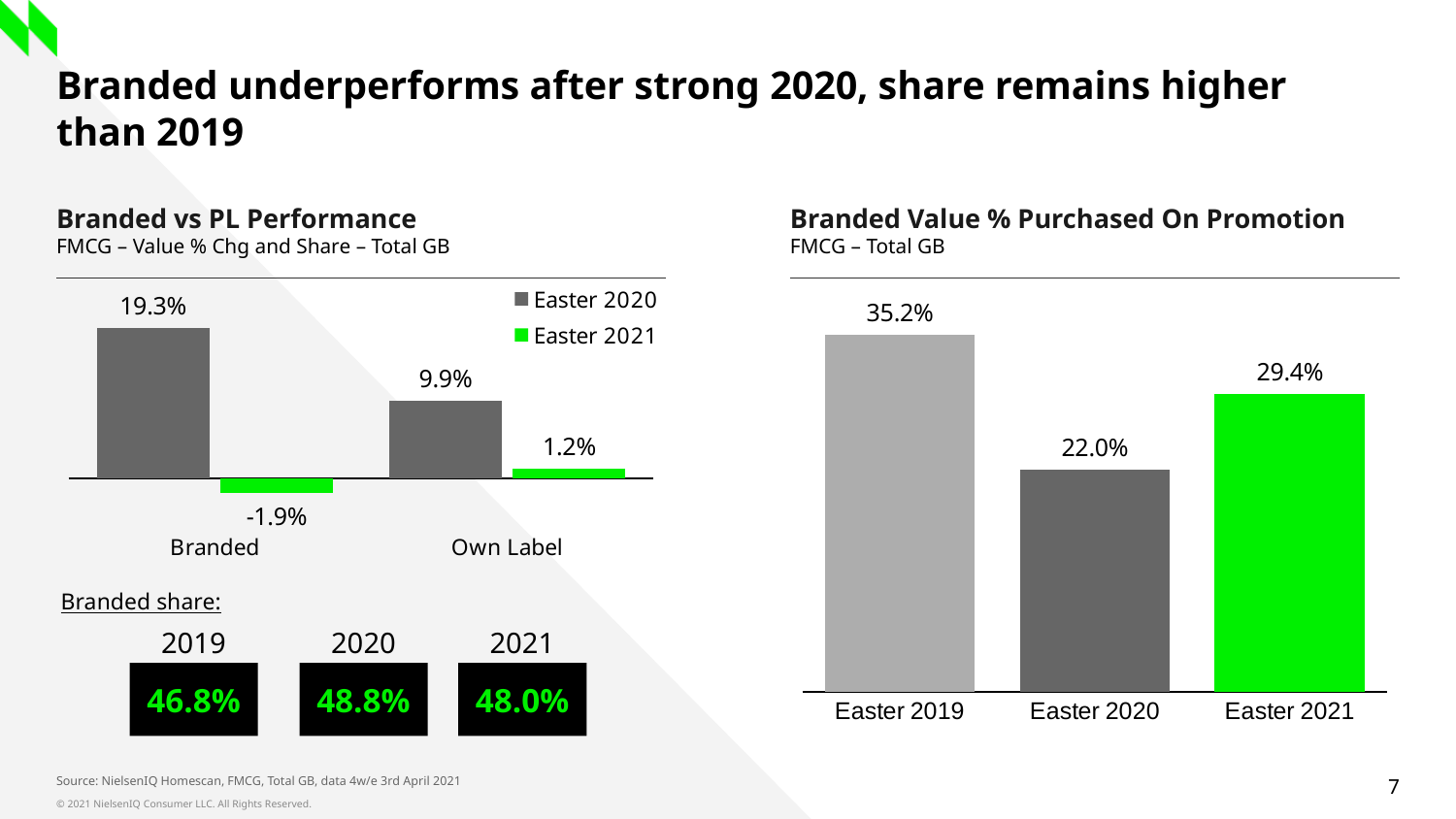
In the 'Branded vs PL Performance' chart, which category has the higher Easter 2021 value, Branded or Own Label? Own Label In the 'Branded vs PL Performance' chart, what is the Easter 2021 value for Own Label? 1.2% In the 'Branded vs PL Performance' chart, what is the Easter 2021 value for Branded? -1.9% In the 'Branded Value % Purchased On Promotion' chart, what is the value for Easter 2020? 22.0% What type of chart is the 'Branded Value % Purchased On Promotion' chart? Bar chart In the 'Branded vs PL Performance' chart, how many series does the legend list? 2 In the 'Branded Value % Purchased On Promotion' chart, which period has the highest value? Easter 2019 In the 'Branded Value % Purchased On Promotion' chart, what is the difference between Easter 2021 and Easter 2020? 7.4 percentage points In the 'Branded vs PL Performance' chart, which colour represents Easter 2021? Green In the 'Branded Value % Purchased On Promotion' chart, which period has the lowest value? Easter 2020 In the 'Branded vs PL Performance' chart, what is the difference between the Easter 2020 values for Branded and Own Label? 9.4 percentage points In the 'Branded vs PL Performance' chart, what is the Easter 2020 value for Branded? 19.3%